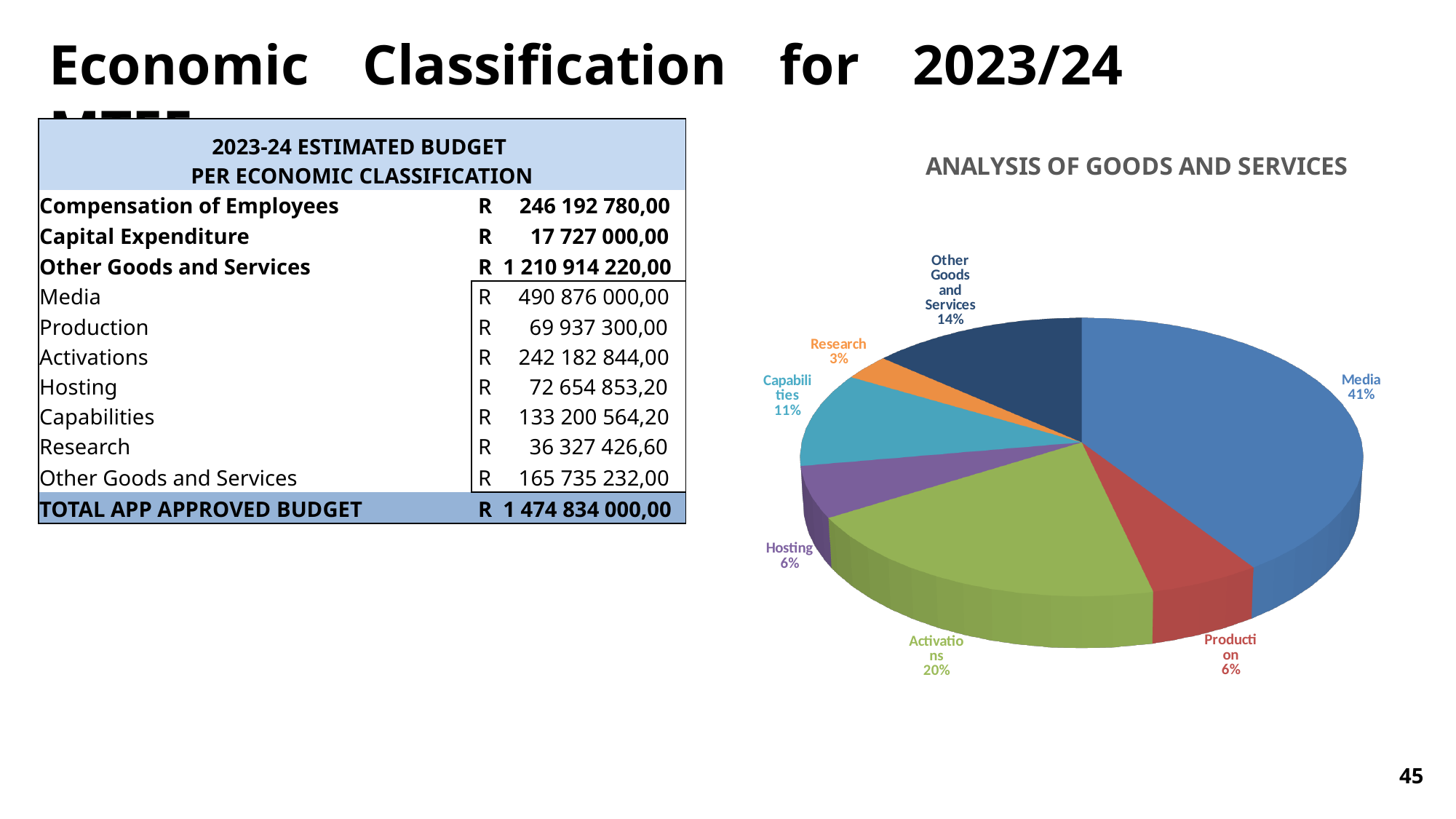
What is the title of the chart? ANALYSIS OF GOODS AND SERVICES What share of the pie does Other Goods and Services represent? 14% Which slice of the pie is the largest? Media Which slice is larger, Capabilities or Hosting? Capabilities What share of the pie does Media represent? 41% What share of the pie does Research represent? 3% How many slices does the pie chart have? 7 What type of chart is shown on the slide? pie chart Which slice of the pie is the smallest? Research What is the difference in percentage points between the Media and Activations slices? 21